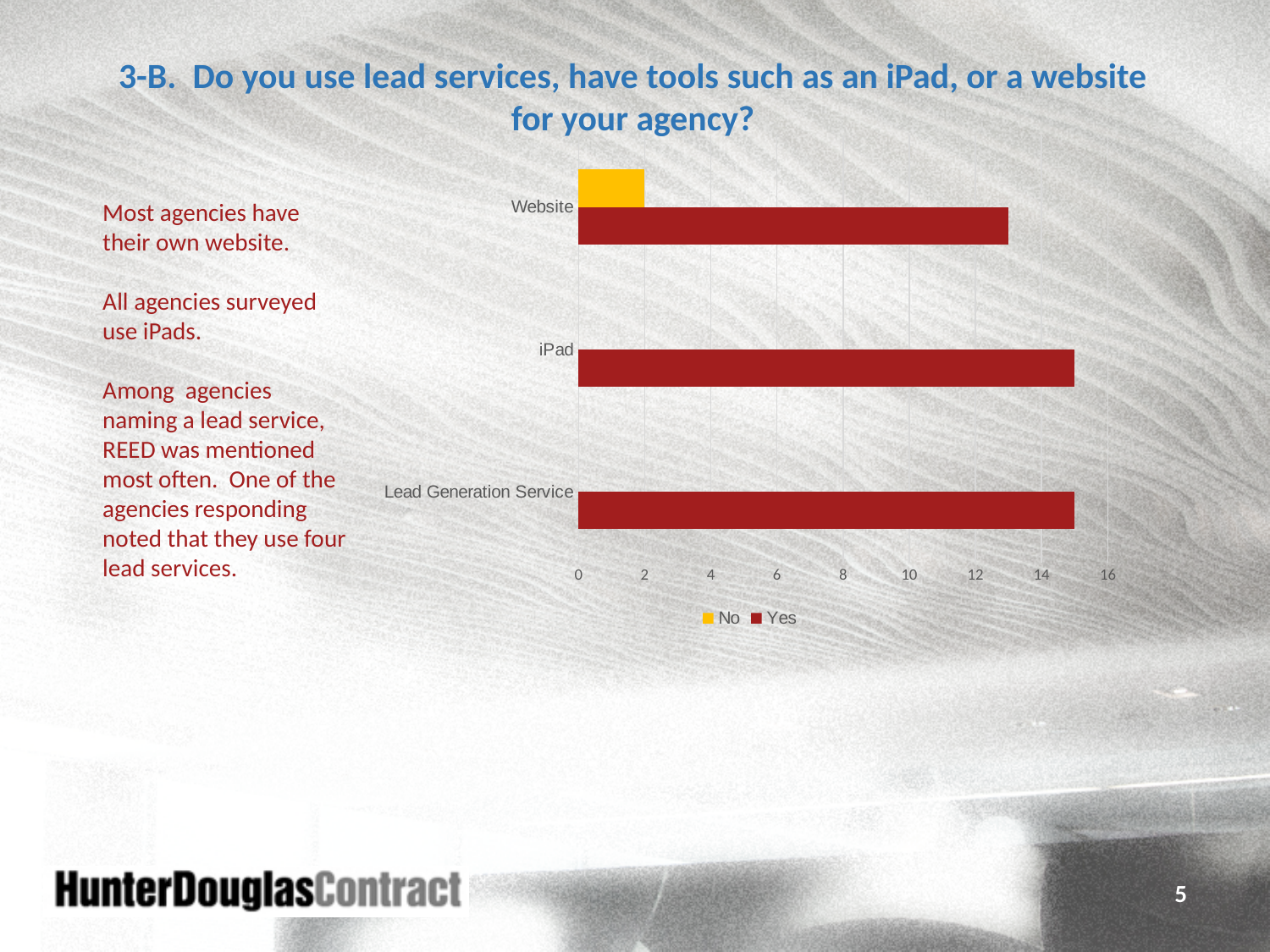
What are the two series named in the chart legend? No and Yes Which category has the lowest "Yes" value? Website Which colour represents the "Yes" series in the chart? red What is the "No" value for Website? 2 Is the "Yes" value for Website greater or less than 12? greater Is the "Yes" value for Website greater or less than 14? less What kind of chart is shown on the slide? bar chart Is the "Yes" value for iPad greater or less than 14? greater How many series does the chart legend list? 2 Which has a larger "Yes" value, iPad or Website? iPad How many categories are shown on the chart? 3